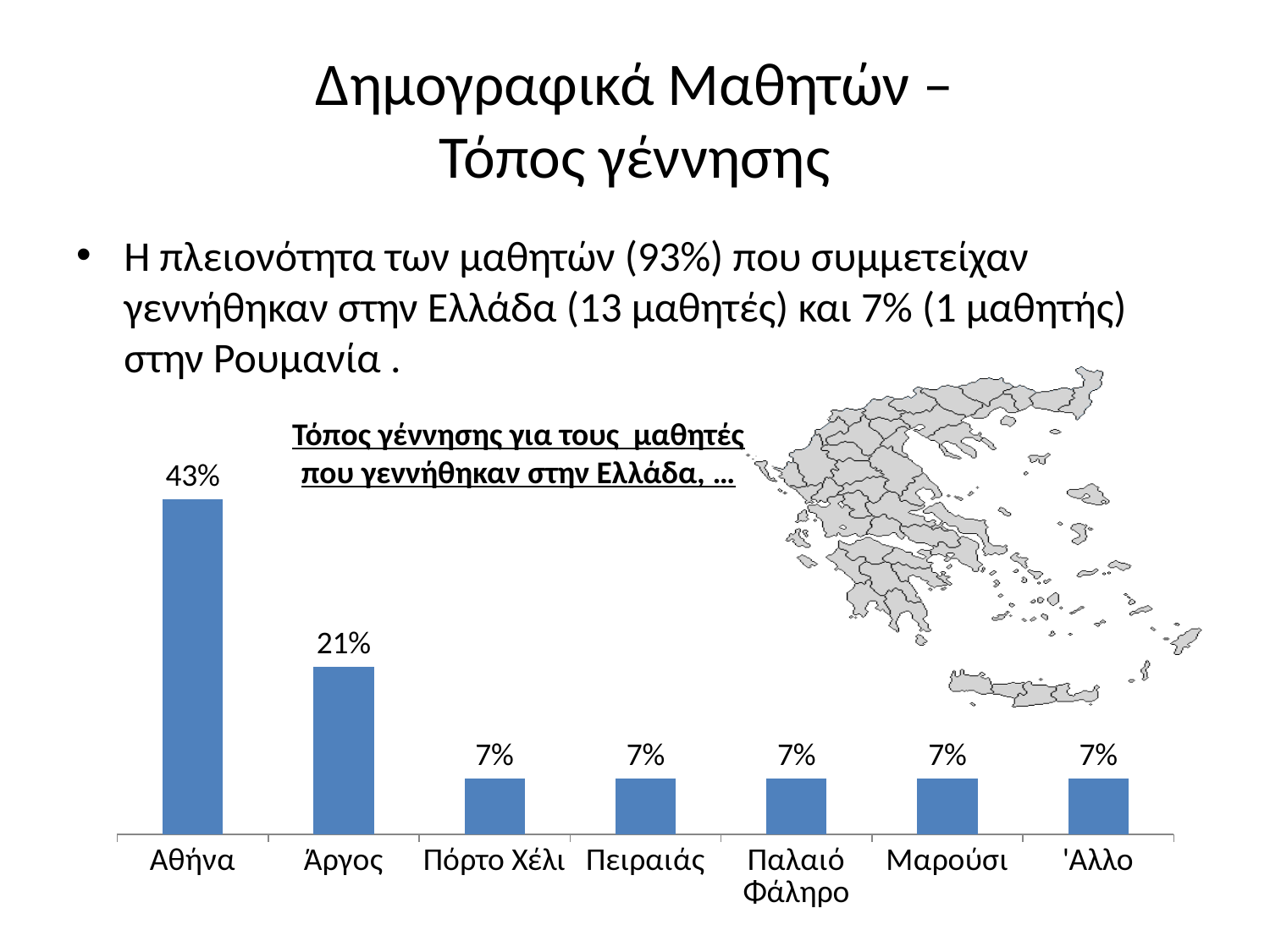
How many categories have a value of 7%? 5 What is the value for Παλαιό Φάληρο? 7% What is the value for Άργος? 21% What kind of chart is this? Bar chart What is the value for Αθήνα? 43% What is the difference between the values for Αθήνα and Άργος? 22% How many categories are shown on the x axis? 7 What is the value for Πειραιάς? 7% What is the value for Άλλο? 7% Which is larger, the value for Άργος or the value for Πόρτο Χέλι? Άργος What is the difference between the values for Άργος and Μαρούσι? 14% Which category has the highest value? Αθήνα